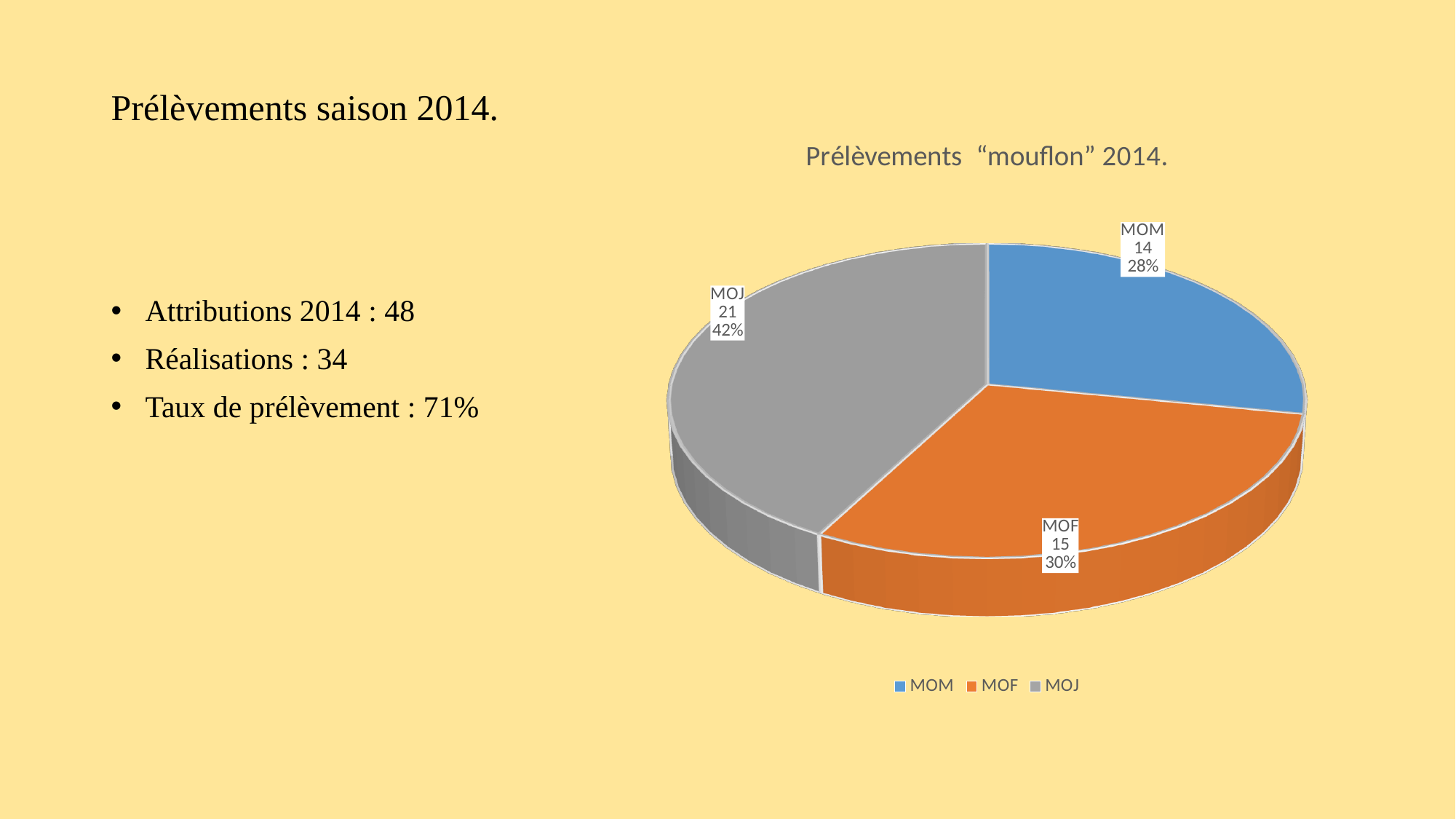
What is the value for MOM in the pie chart? 14 Which is larger, the value for MOJ or the value for MOF? MOJ What share of the pie does MOM represent? 28% How many categories are shown in the pie chart? 3 What share of the pie does MOJ represent? 42% What is the difference between the values for MOJ and MOM? 7 Which category has the largest slice of the pie? MOJ What is the value for MOJ in the pie chart? 21 What is the value for MOF in the pie chart? 15 What kind of chart is shown on the slide? Pie chart What is the title of the chart? Prélèvements "mouflon" 2014. Which category has the smallest slice of the pie? MOM